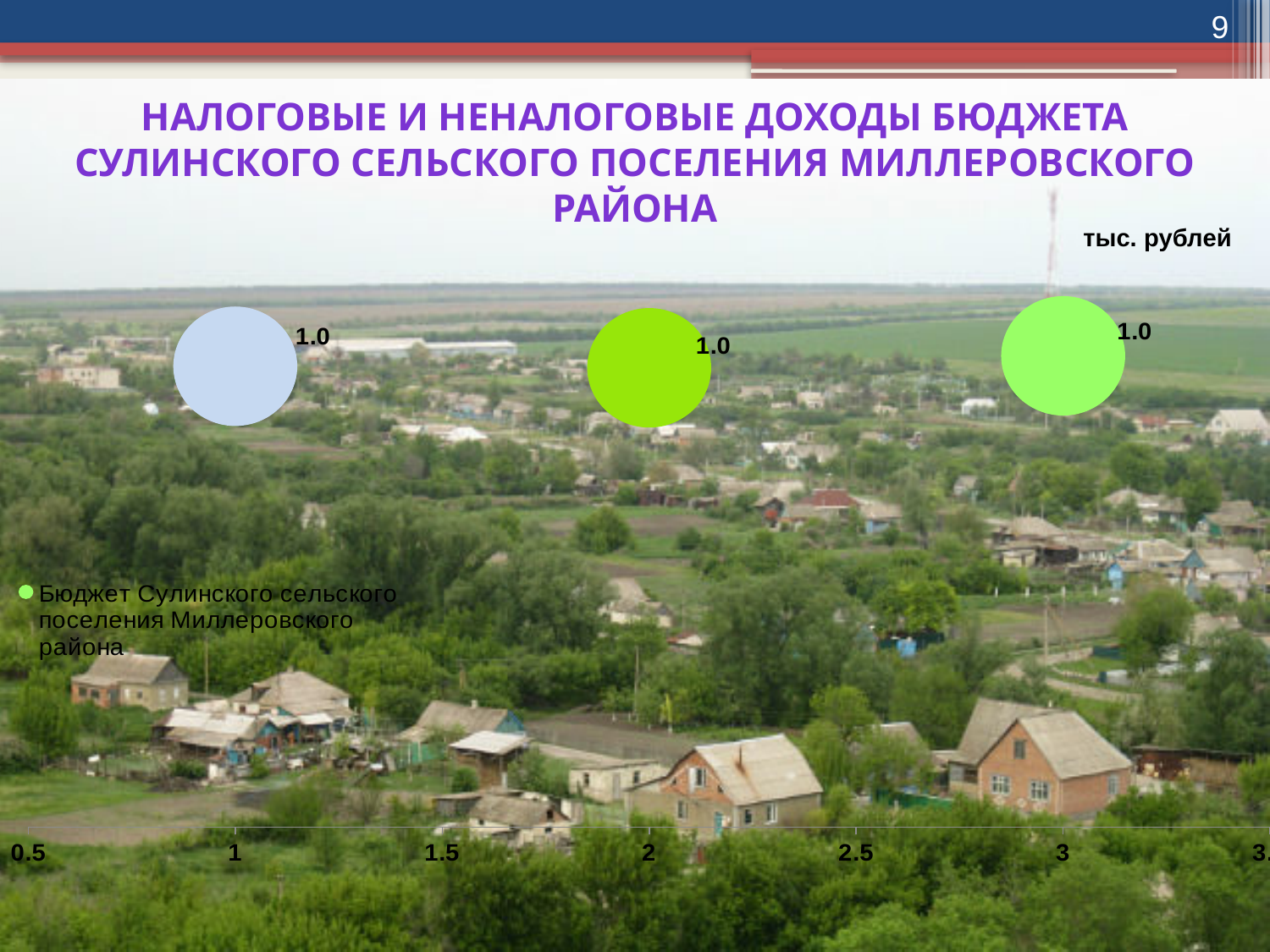
What is the data label on the leftmost bubble? 1.0 What is the data label on the middle bubble? 1.0 What unit of measurement is indicated above the chart? тыс. рублей Is the labelled value of the leftmost bubble larger than, smaller than, or equal to the labelled value of the rightmost bubble? equal What series name does the legend show? Бюджет Сулинского сельского поселения Миллеровского района What kind of chart is shown on the slide? bubble chart What is the lowest tick value shown on the x axis? 0.5 What is the difference between the labelled values of the middle bubble and the leftmost bubble? 0.0 What is the total of the three labelled bubble values? 3.0 What is the data label on the rightmost bubble? 1.0 How many bubbles (data points) are plotted on the chart? 3 How many series does the legend list? 1